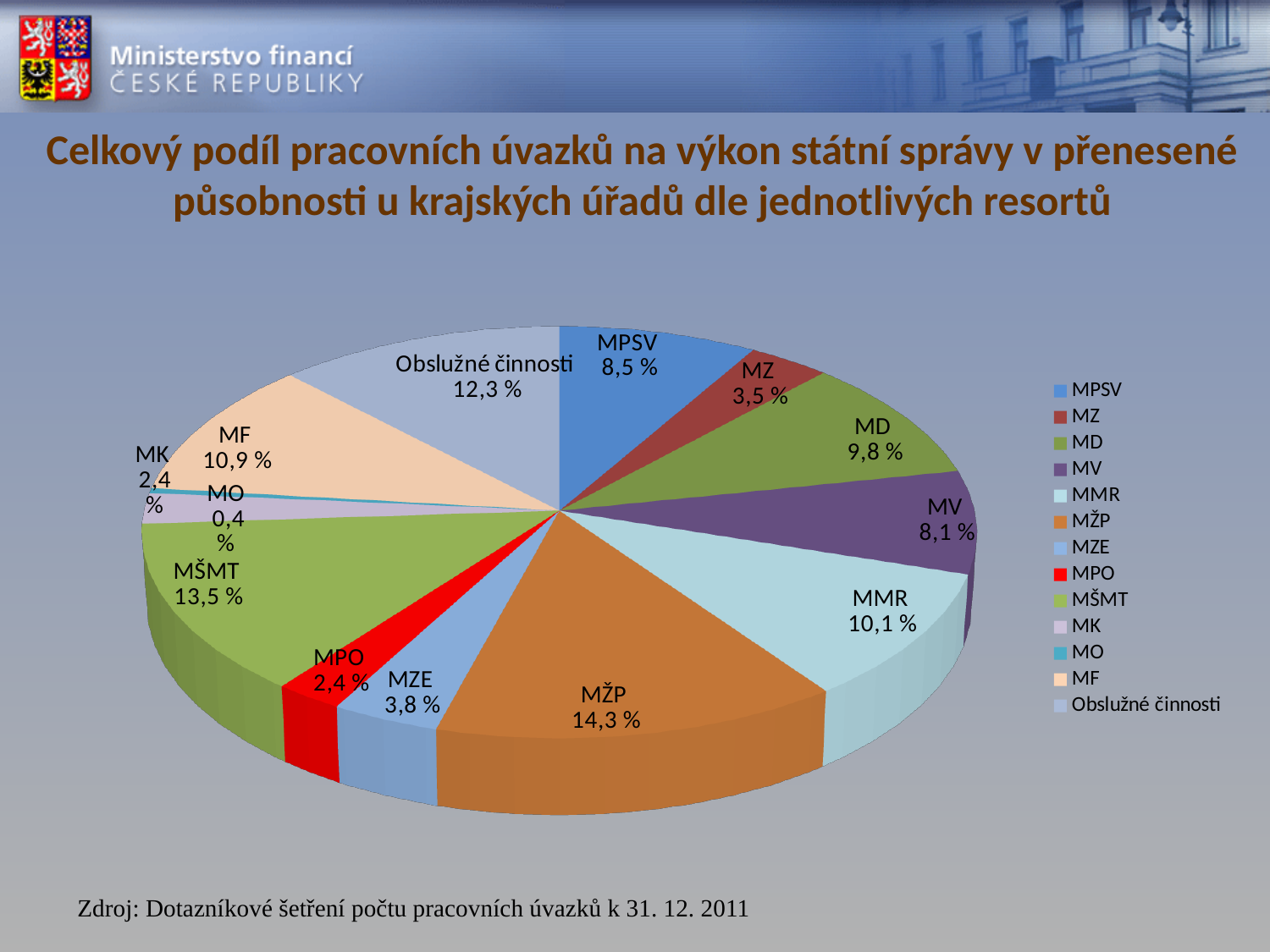
What is the difference between the shares of MŽP and MŠMT? 0,8 % How many slices does the pie chart have? 13 What kind of chart is shown on the slide? pie chart Which category has the smallest share of the pie? MO What is the share for Obslužné činnosti? 12,3 % What is the share for MŽP? 14,3 % How many entries does the legend list? 13 Which category has the largest share of the pie? MŽP What colour is the MPO slice? red What is the share for MŠMT? 13,5 % What is the share for MO? 0,4 % Which has a larger share, MMR or MD? MMR